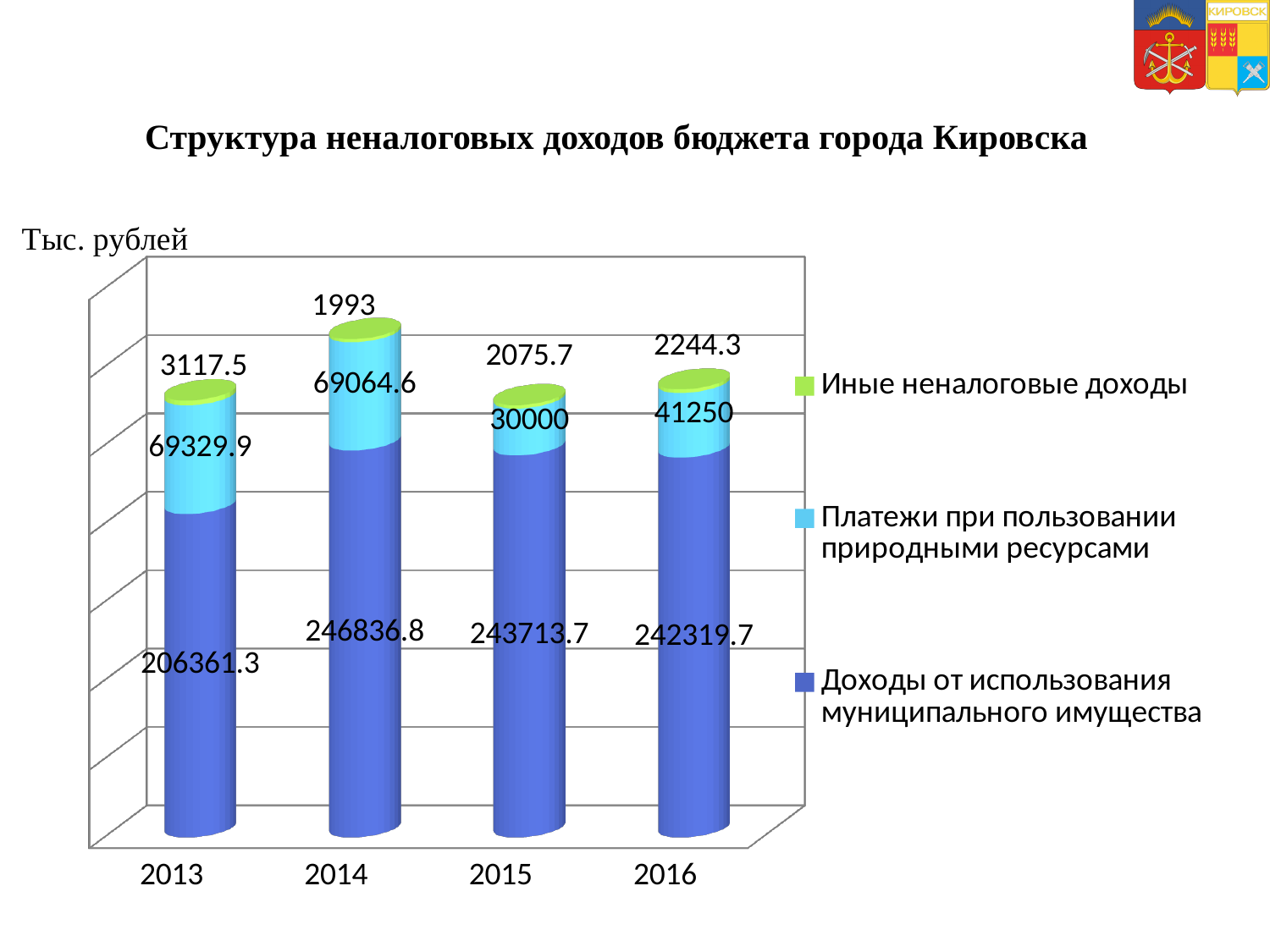
What type of chart is shown on the slide? Stacked bar chart By how much did 'Доходы от использования муниципального имущества' increase from 2013 to 2014? 40475.5 In which year is 'Доходы от использования муниципального имущества' the highest? 2014 What is the value of 'Платежи при пользовании природными ресурсами' in 2015? 30000 What is the title of the chart? Структура неналоговых доходов бюджета города Кировска How many years are shown on the x axis? 4 What is the value of 'Доходы от использования муниципального имущества' in 2013? 206361.3 How many series does the legend list? 3 In which year is 'Иные неналоговые доходы' the lowest? 2014 What is the total of the stacked bar for 2015? 275789.4 Which year has the larger value for 'Платежи при пользовании природными ресурсами', 2015 or 2016? 2016 What is the value of 'Иные неналоговые доходы' in 2016? 2244.3